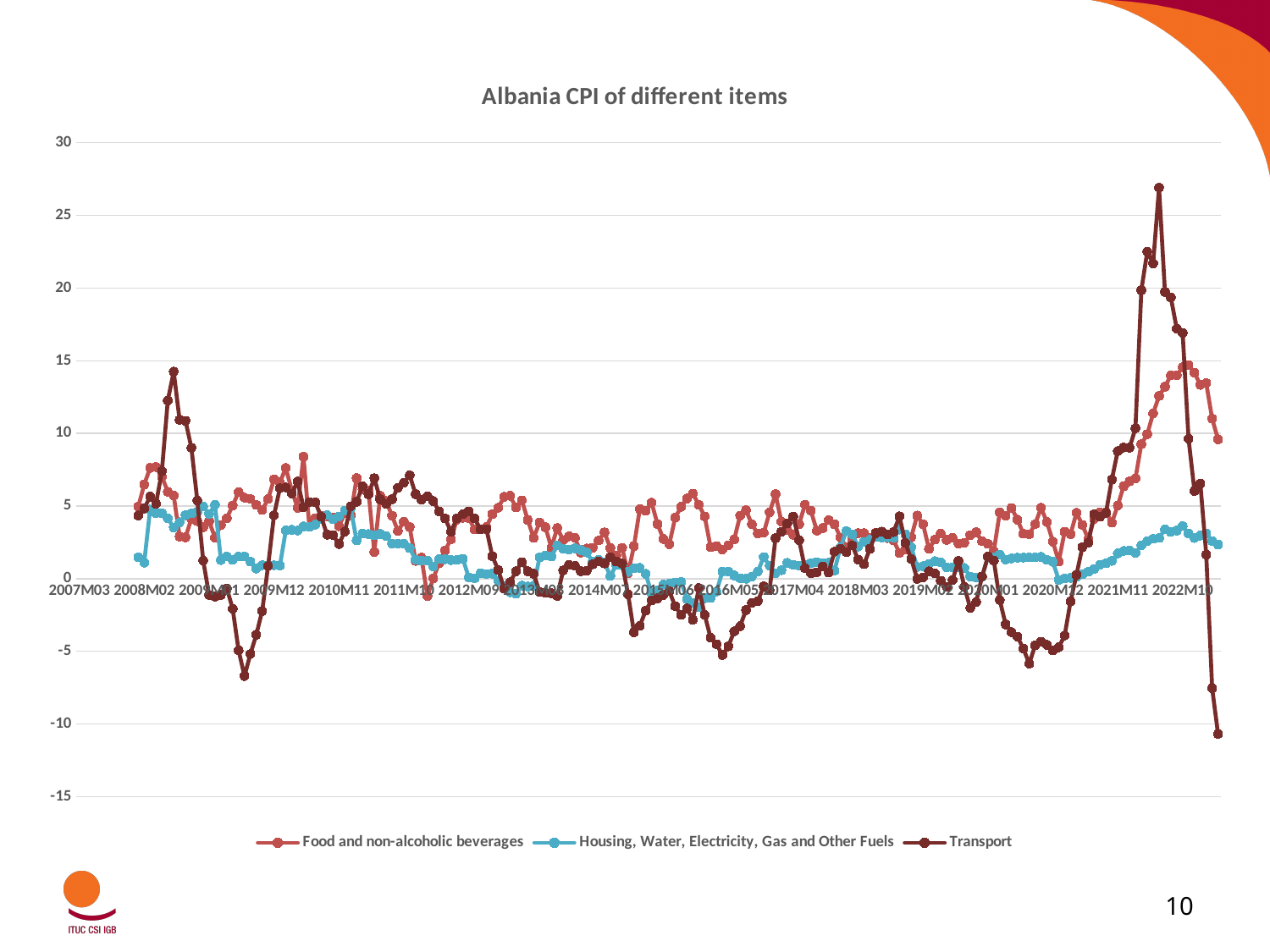
What is the title of the chart? Albania CPI of different items Which series reaches the highest value anywhere on the chart? Transport Is the lowest value of the Transport series greater or less than -5? less How many date labels are shown along the x axis? 18 Is the peak value of the Food and non-alcoholic beverages series greater or less than 10? greater Is the highest value of the Housing, Water, Electricity, Gas and Other Fuels series greater or less than 10? less Which series reaches the lowest value anywhere on the chart? Transport Which series is drawn in blue according to the legend? Housing, Water, Electricity, Gas and Other Fuels Does the Transport series rise or fall over the last few points at the right end of the chart? fall How many series does the legend list? 3 What kind of chart is shown on the slide? Line chart